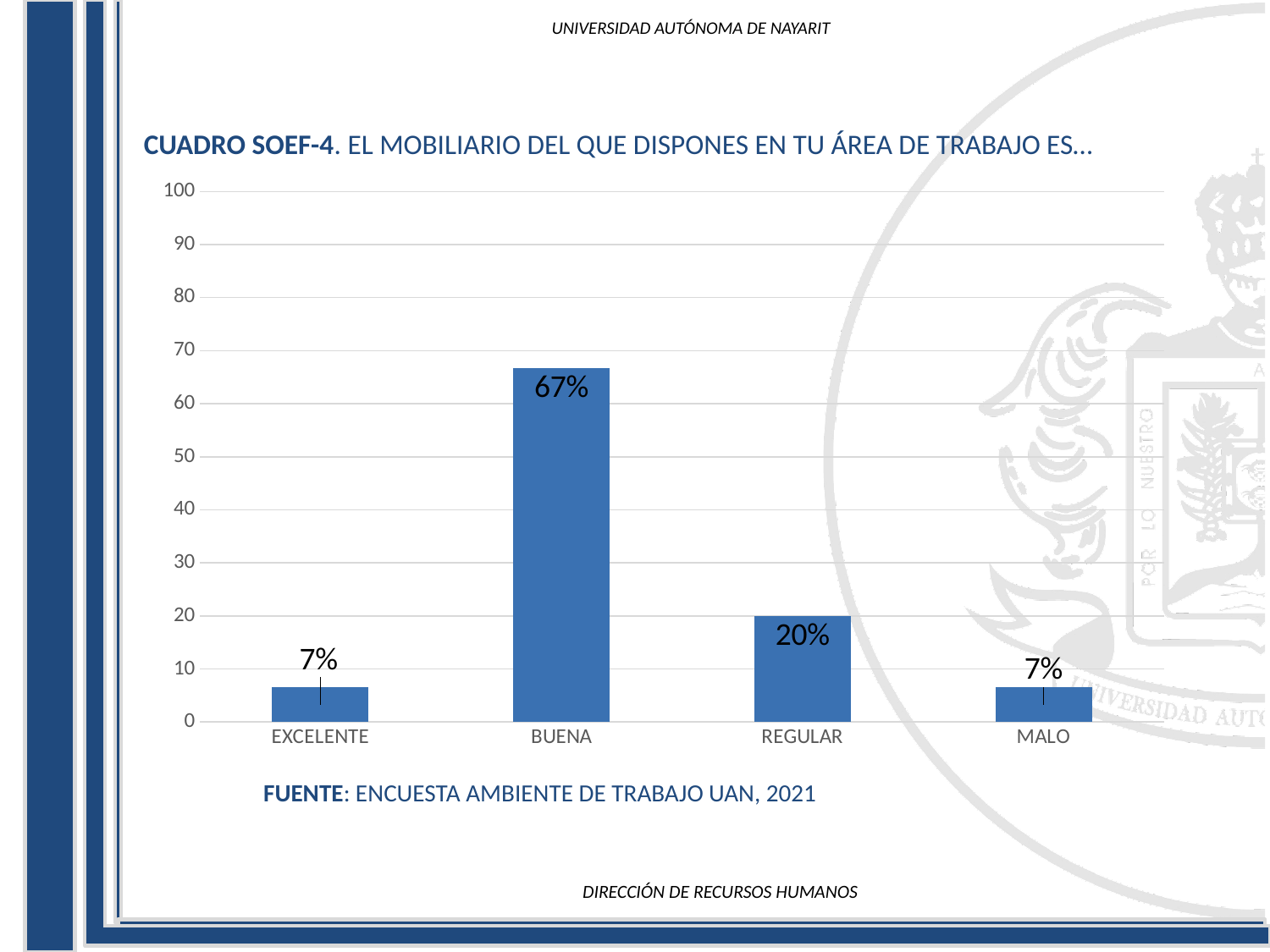
Which category has the highest value? BUENA What is the value for EXCELENTE? 7% What is the highest value shown on the y axis? 100 What is the value for REGULAR? 20% How many categories are shown on the x axis? 4 What is the source cited below the chart? ENCUESTA AMBIENTE DE TRABAJO UAN, 2021 What is the difference between the values for BUENA and REGULAR? 47% Which is larger, the value for REGULAR or the value for MALO? REGULAR What kind of chart is shown on the slide? bar chart What is the value for MALO? 7% Is the value for BUENA greater or less than 60? greater What is the value for BUENA? 67%